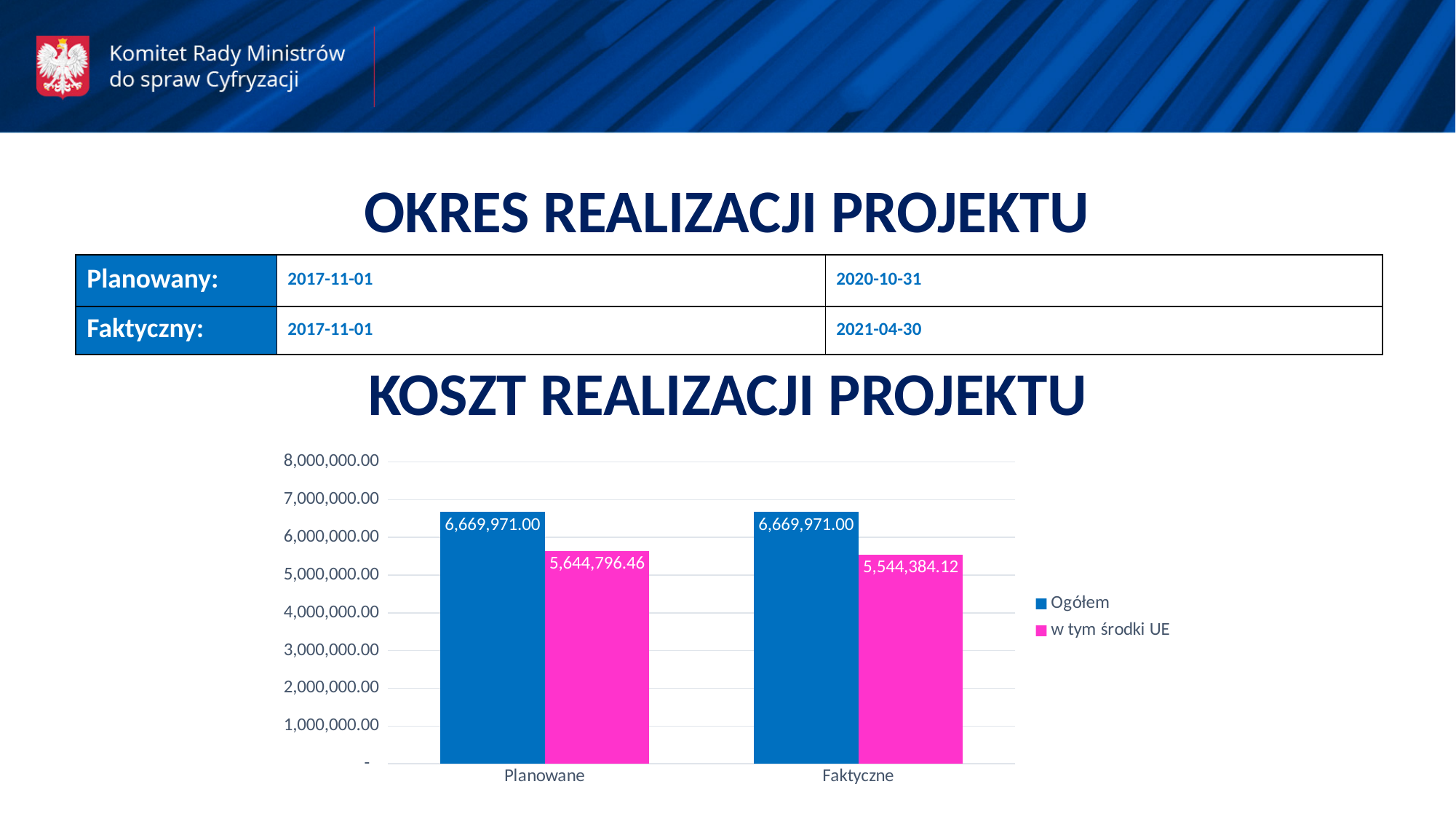
What is the value of w tym środki UE for Faktyczne? 5,544,384.12 How many series does the chart legend list? 2 What is the difference between Ogółem and w tym środki UE for Faktyczne? 1,125,586.88 What type of chart is shown under the heading KOSZT REALIZACJI PROJEKTU? Bar chart What is the value of w tym środki UE for Planowane? 5,644,796.46 Which is larger for Faktyczne: Ogółem or w tym środki UE? Ogółem What is the value of Ogółem for Faktyczne? 6,669,971.00 What is the difference between the w tym środki UE values for Planowane and Faktyczne? 100,412.34 How many categories are shown on the x axis of the chart? 2 What is the value of Ogółem for Planowane? 6,669,971.00 What is the difference between Ogółem and w tym środki UE for Planowane? 1,025,174.54 Which category has the lower value for w tym środki UE? Faktyczne